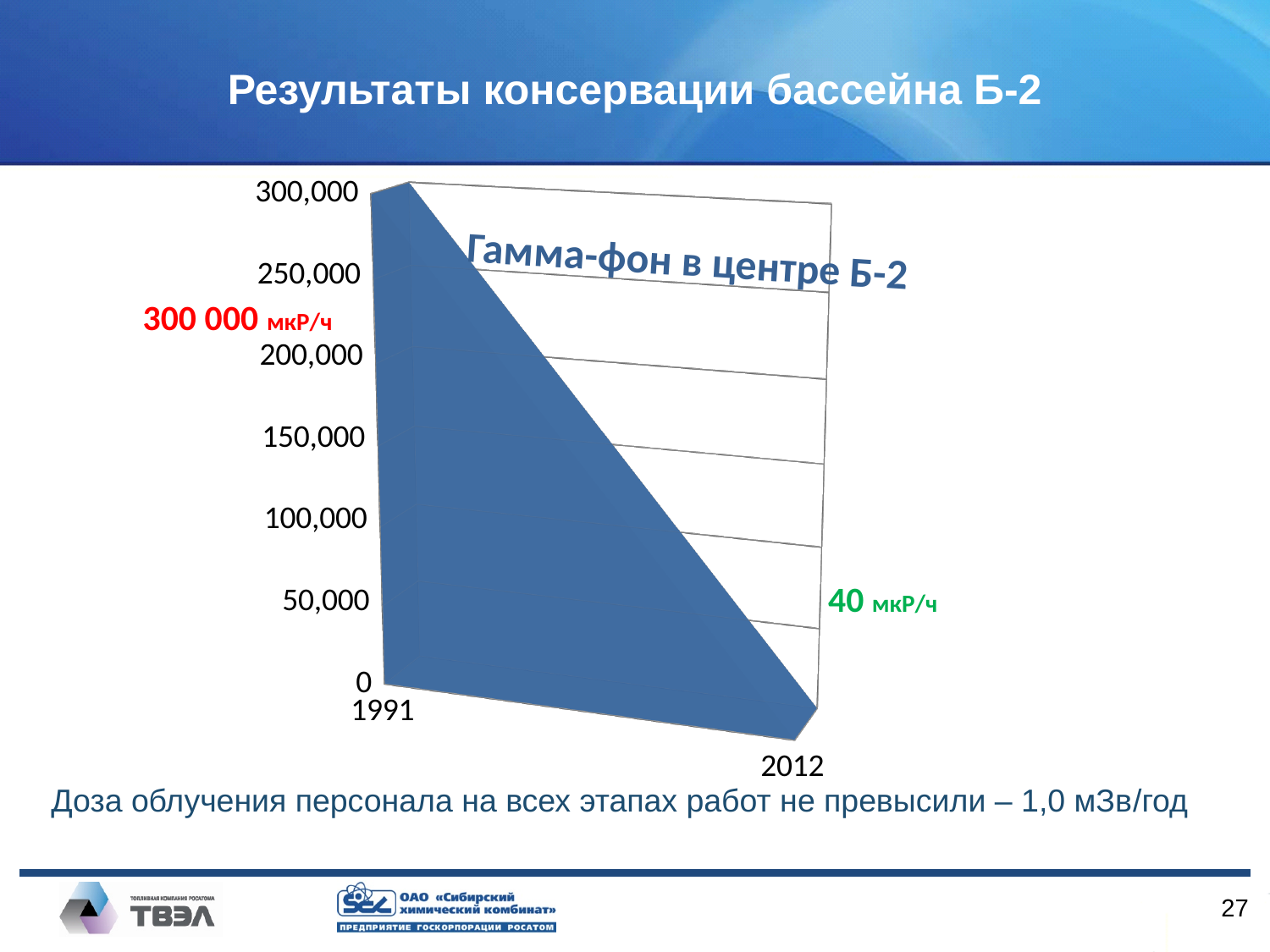
What is the highest value shown on the y axis of the chart? 300,000 Which year has the lowest gamma background value on the chart? 2012 Is the value for 2012 greater or less than 50,000? less What is the gamma background value shown for 2012? 40 мкР/ч Which year has the higher gamma background value, 1991 or 2012? 1991 What is the title of the chart? Гамма-фон в центре Б-2 Does the gamma background value rise or fall from 1991 to 2012? fall What kind of chart is shown on the slide? area chart How many years are labelled on the x axis of the chart? 2 What is the gamma background value shown for 1991? 300 000 мкР/ч By how much did the gamma background value decrease from 1991 to 2012? 299 960 мкР/ч Which year has the highest gamma background value on the chart? 1991